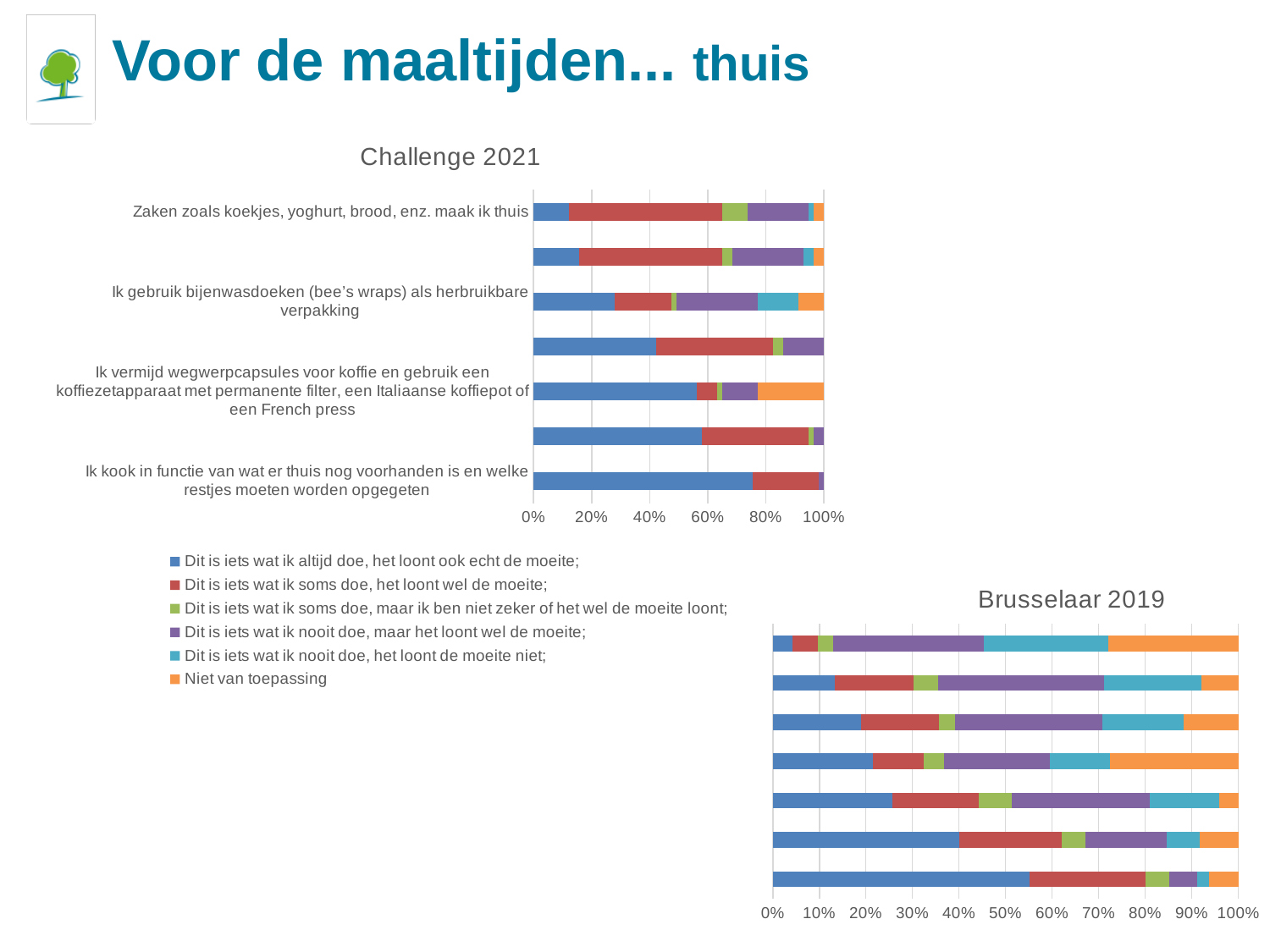
In the Challenge 2021 chart, is the 'Dit is iets wat ik altijd doe' share for 'Ik kook in functie van wat er thuis nog voorhanden is en welke restjes moeten worden opgegeten' greater or less than 60%? greater In the Challenge 2021 chart, which of the four labeled categories has the largest 'Dit is iets wat ik altijd doe' share? Ik kook in functie van wat er thuis nog voorhanden is en welke restjes moeten worden opgegeten In the Brusselaar 2019 chart, is the blue 'Dit is iets wat ik altijd doe' share of the bottom bar greater or less than 50%? greater In the Challenge 2021 chart, is the 'Dit is iets wat ik altijd doe' share for 'Ik gebruik bijenwasdoeken (bee's wraps) als herbruikbare verpakking' greater or less than 40%? less How many bars does the Brusselaar 2019 chart show? 7 What kind of chart is the Challenge 2021 chart? Stacked bar chart How many series does the legend list? 6 In the Challenge 2021 chart, which has the larger 'Dit is iets wat ik altijd doe' share: 'Ik kook in functie van wat er thuis nog voorhanden is...' or 'Zaken zoals koekjes, yoghurt, brood, enz. maak ik thuis'? Ik kook in functie van wat er thuis nog voorhanden is en welke restjes moeten worden opgegeten Which legend entry is shown in orange? Niet van toepassing How many bars does the Challenge 2021 chart show? 7